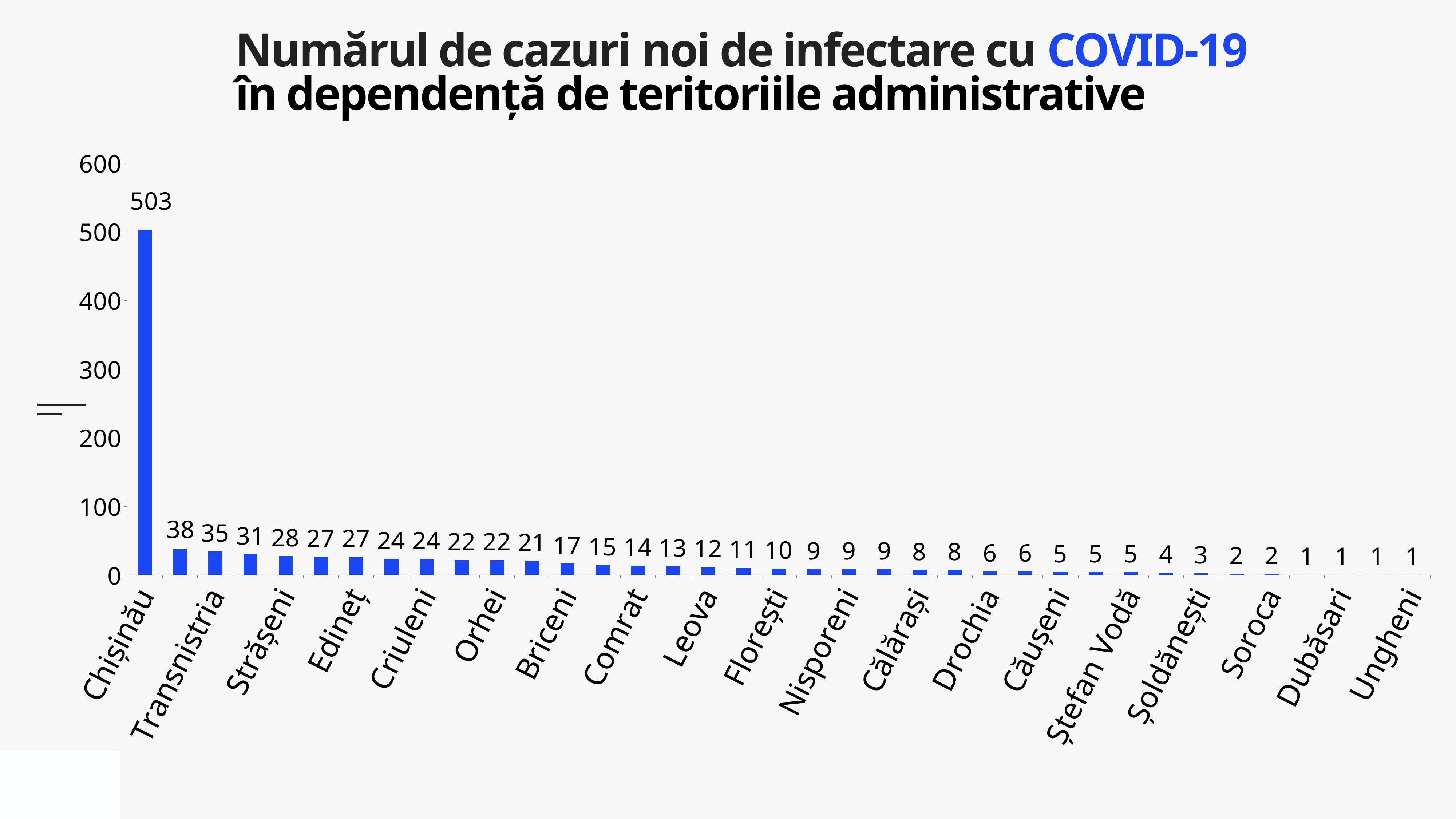
Which territory has the highest number of new cases? Chișinău Is the value for Transnistria greater or less than 100? less What is the difference between the values for Chișinău and Ungheni? 502 What colour are the bars in the chart? blue What is the value for Ungheni? 1 Do the values rise or fall from left to right along the x axis? fall Which is larger, the value for Chișinău or the value for Transnistria? Chișinău What is the value for Chișinău? 503 Is the value for Chișinău greater or less than 400? greater What is the value for Dubăsari? 1 What kind of chart is shown on the slide? bar chart What is the highest tick value shown on the vertical axis? 600